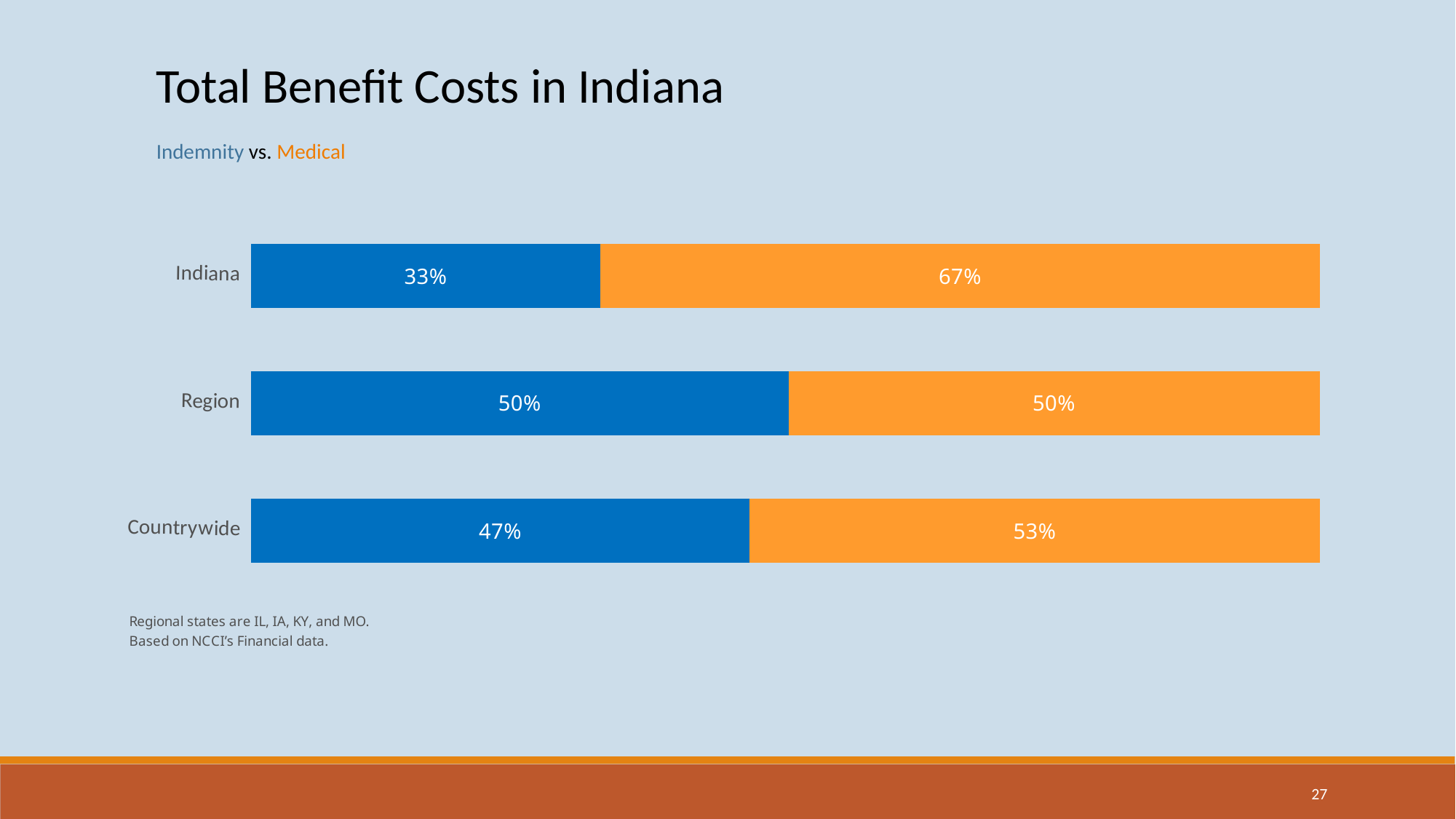
How many categories are shown on the chart? 3 What is the Medical share for Indiana? 67% What kind of chart is shown on the slide? Stacked bar chart Which category has the highest Medical share? Indiana What is the Indemnity share for Countrywide? 47% What is the Medical share for Region? 50% What is the Indemnity share for Indiana? 33% Which is larger for Countrywide, the Indemnity share or the Medical share? Medical What is the difference between the Medical and Indemnity shares for Indiana? 34% How many series does the chart show? 2 Which category has the lowest Indemnity share? Indiana What is the total of the stacked bar for Region? 100%